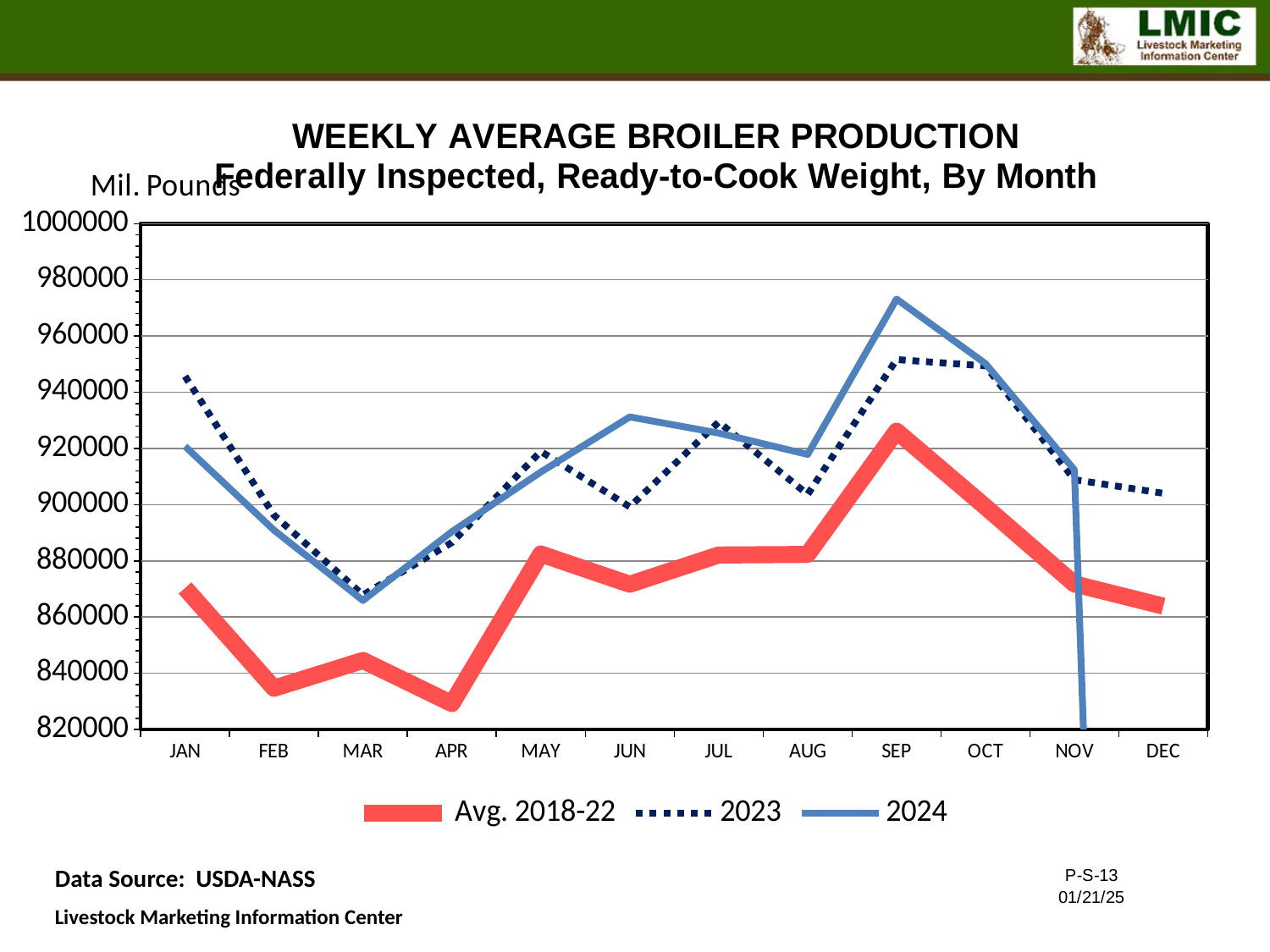
What unit label is shown above the y axis? Mil. Pounds In which month is the 2023 series at its lowest value? MAR In JAN, which series has the larger value, 2023 or 2024? 2023 In which month is the Avg. 2018-22 series at its lowest value? APR Is the 2024 value for MAR greater or less than 880000? less In SEP, which series has the larger value, 2023 or 2024? 2024 Is the Avg. 2018-22 value for JAN greater or less than 880000? less Is the 2024 value for SEP greater or less than 960000? greater How many months are shown along the x axis? 12 In which month does the 2024 series reach its highest value? SEP How many series does the legend list? 3 What kind of chart is shown on the slide? line chart